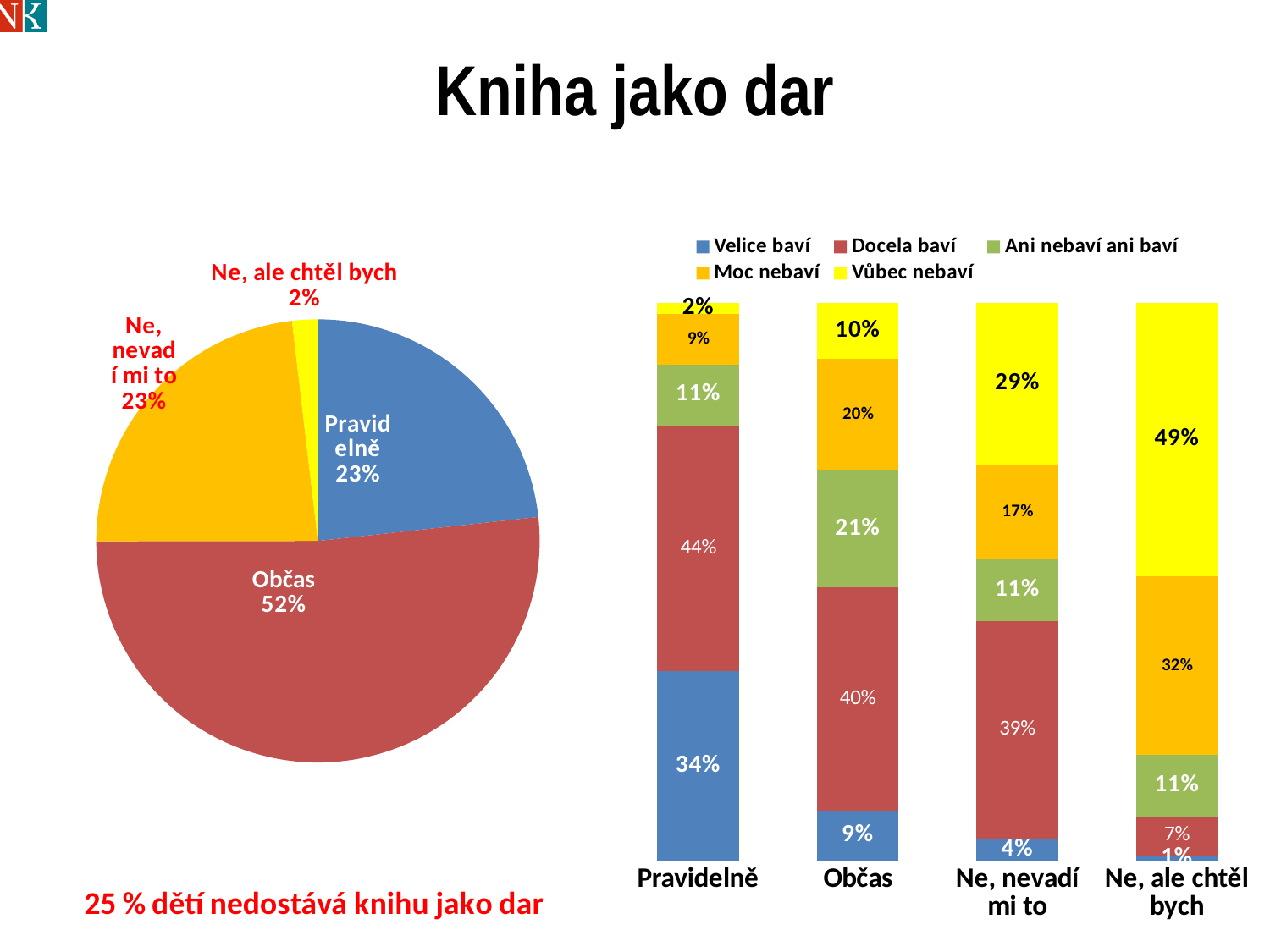
In the stacked bar chart on the right, which is larger: 'Vůbec nebaví' for 'Ne, nevadí mi to' or 'Vůbec nebaví' for 'Občas'? Ne, nevadí mi to In the pie chart on the left, which category has the largest slice? Občas In the pie chart on the left, what share does the slice 'Občas' have? 52% In the stacked bar chart on the right, which category has the highest 'Velice baví' value? Pravidelně In the stacked bar chart on the right, what is the difference between the 'Docela baví' values for 'Pravidelně' and 'Ne, ale chtěl bych'? 37% In the pie chart on the left, which category has the smallest slice? Ne, ale chtěl bych What type of chart is shown on the right side of the slide? Stacked bar chart In the stacked bar chart on the right, what is the value of 'Vůbec nebaví' for 'Ne, ale chtěl bych'? 49% In the pie chart on the left, how many slices are there? 4 In the stacked bar chart on the right, what is the value of 'Moc nebaví' for 'Občas'? 20% In the stacked bar chart on the right, what is the value of 'Velice baví' for 'Pravidelně'? 34% In the stacked bar chart on the right, how many series does the legend list? 5